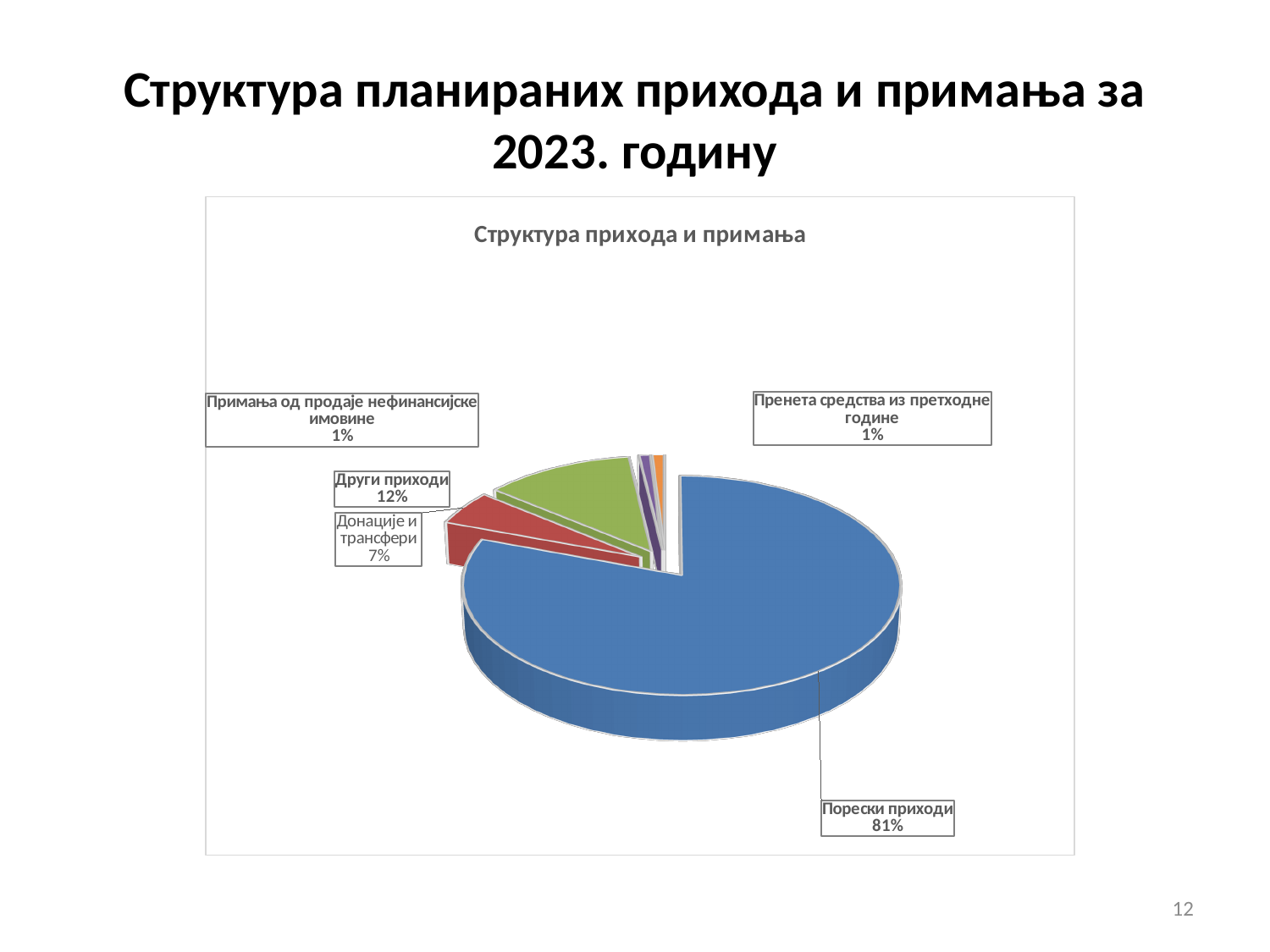
Which category has the largest share of the pie? Порески приходи What type of chart is shown on the slide? pie chart What is the difference in percentage points between Порески приходи and Други приходи? 69 What share of the pie does Донације и трансфери have? 7% What is the title of the chart? Структура прихода и примања What share of the pie does Други приходи have? 12% Which is larger, the share for Други приходи or the share for Донације и трансфери? Други приходи What share of the pie does Пренета средства из претходне године have? 1% What colour is the slice for Порески приходи? blue How many slices does the pie chart have? 5